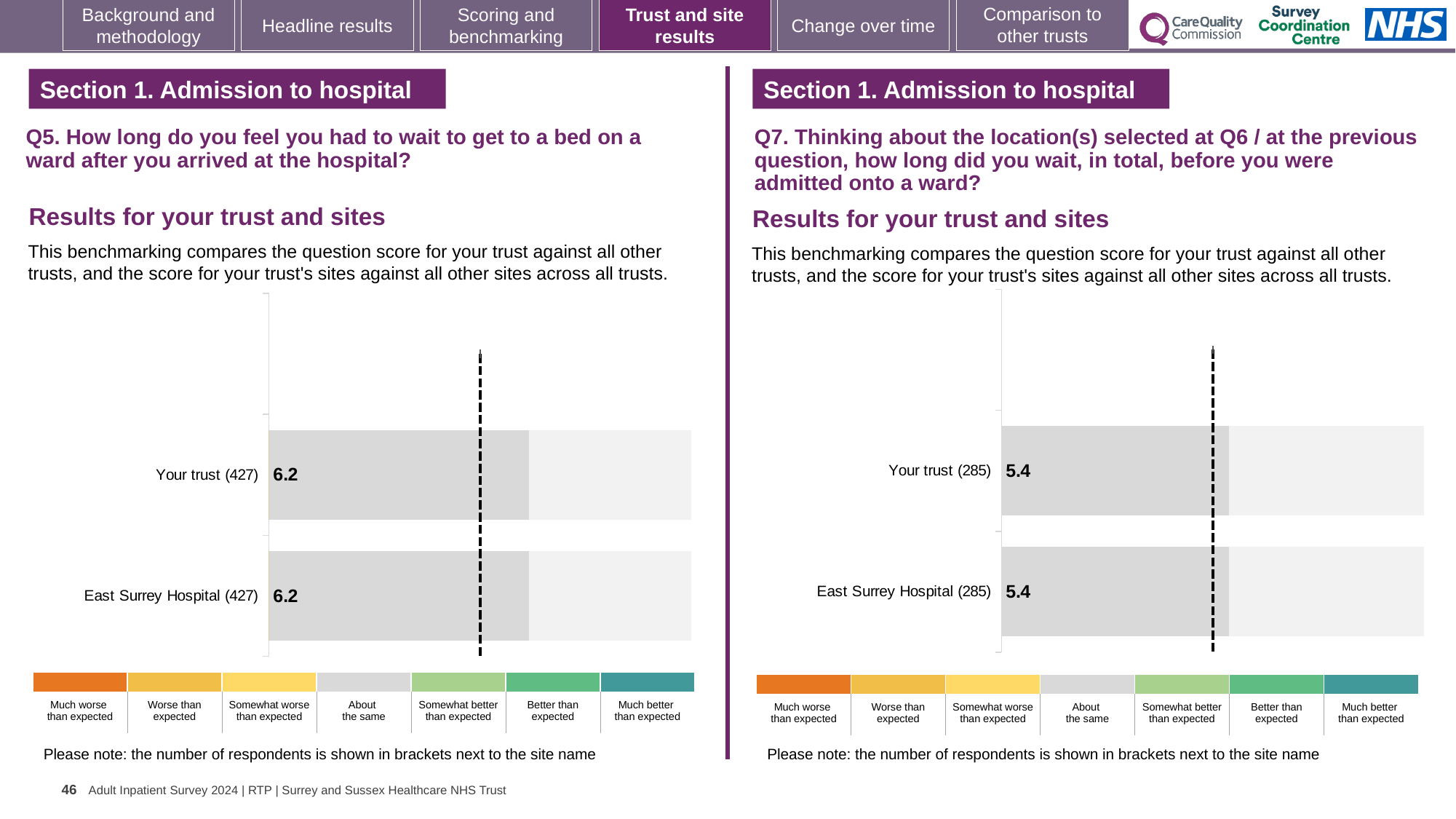
On the right chart (Q7), what is the difference between the score for Your trust and the score for East Surrey Hospital? 0 How many bars are plotted on the right chart (Q7)? 2 On the right chart (Q7), what is the score for Your trust? 5.4 On the left chart (Q5), what is the score for East Surrey Hospital? 6.2 On the left chart (Q5), what is the difference between the score for Your trust and the score for East Surrey Hospital? 0 Is the score for Your trust on the right chart (Q7) greater or less than the score for Your trust on the left chart (Q5)? less On the right chart (Q7), what is the score for East Surrey Hospital? 5.4 What kind of chart is used on the left (Q5)? Bar chart How many bars are plotted on the left chart (Q5)? 2 On the left chart (Q5), how many respondents are shown in brackets next to Your trust? 427 On the right chart (Q7), how many respondents are shown in brackets next to East Surrey Hospital? 285 On the left chart (Q5), what is the score for Your trust? 6.2